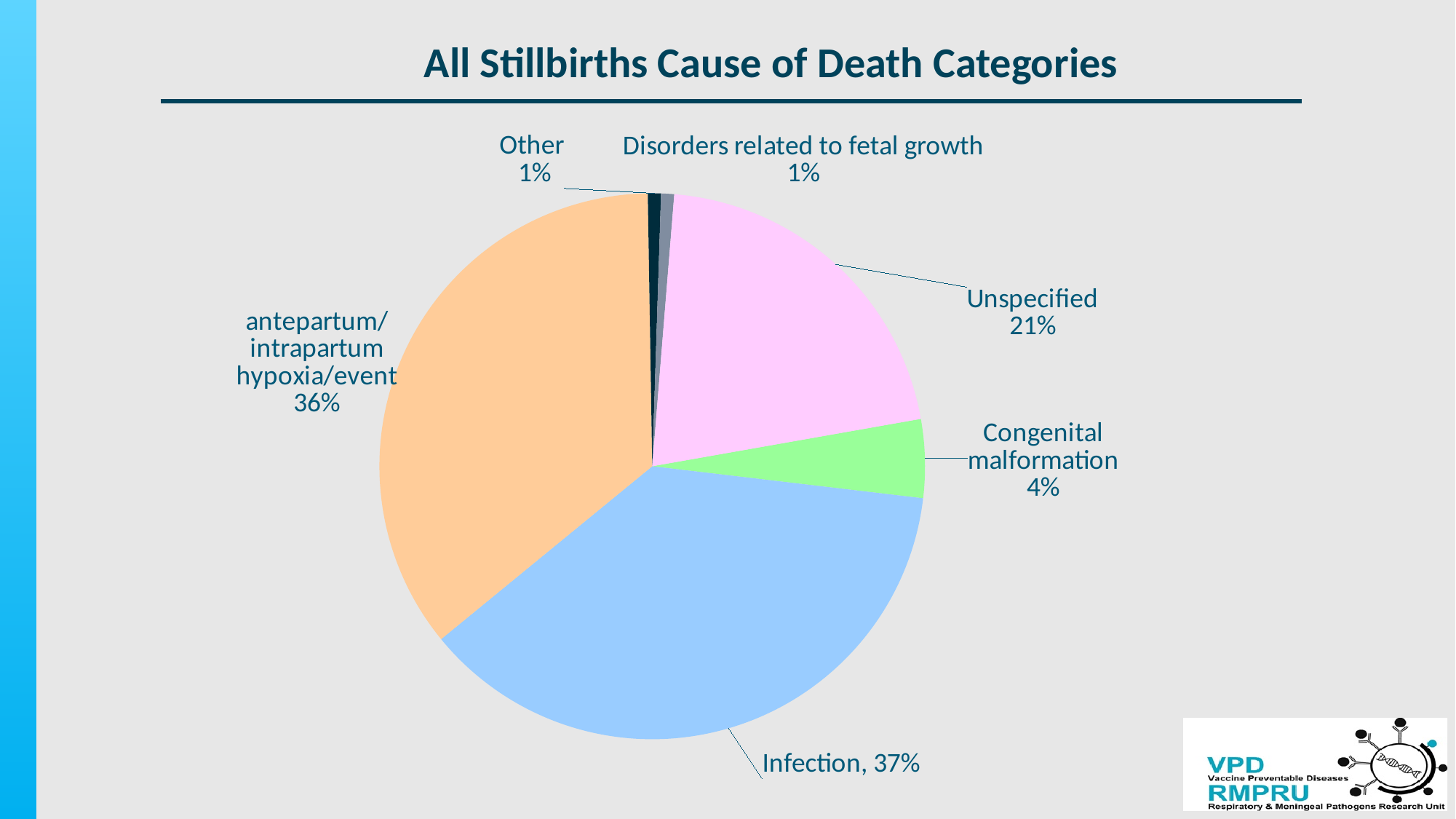
What percentage is shown for Disorders related to fetal growth? 1% Which is larger, the share for Unspecified or the share for Congenital malformation? Unspecified What percentage is shown for Congenital malformation? 4% Which cause of death category has the largest share of the pie? Infection What kind of chart is shown on the slide? pie chart How many categories are shown in the pie chart? 6 What percentage is shown for Unspecified? 21% What share of stillbirths is attributed to Infection? 37% What is the title of the chart? All Stillbirths Cause of Death Categories What is the combined share of Infection and antepartum/intrapartum hypoxia/event? 73% What is the difference in percentage points between Unspecified and Congenital malformation? 17 What percentage is shown for antepartum/intrapartum hypoxia/event? 36%